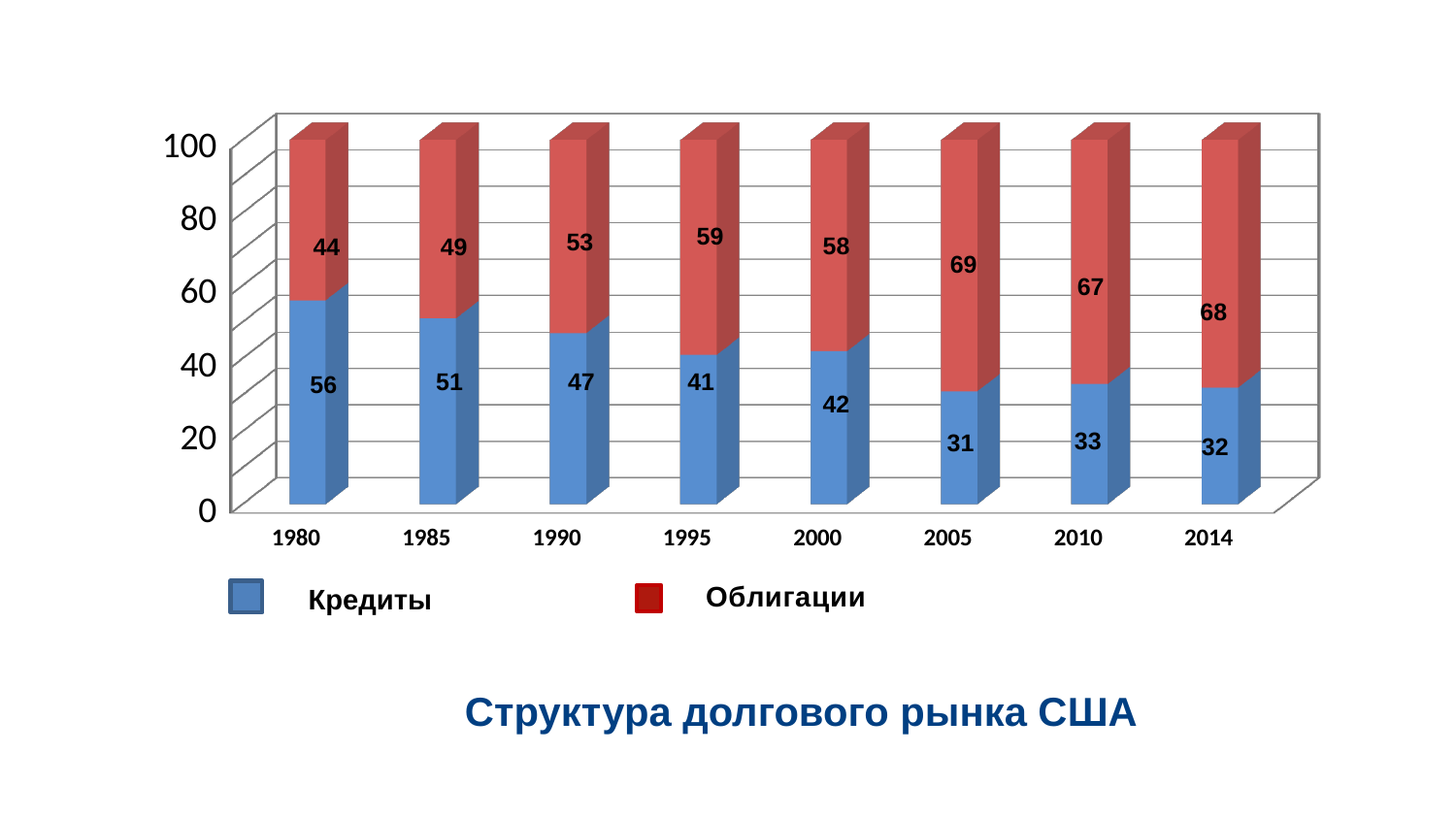
What is the total of the stacked bar for 2000? 100 What is the difference between the Облигации value in 2014 and the Кредиты value in 2014? 36 Does the Кредиты value generally rise or fall from 1980 to 2014? Fall What kind of chart is shown on the slide? Stacked bar chart In which year is the Облигации value highest? 2005 How many series does the legend list? 2 How many years are shown on the x axis? 8 What is the value for Кредиты in 2014? 32 What is the value for Кредиты in 1980? 56 Which is larger in 1990: Кредиты or Облигации? Облигации What is the value for Облигации in 2005? 69 In which year is the Кредиты value lowest? 2005